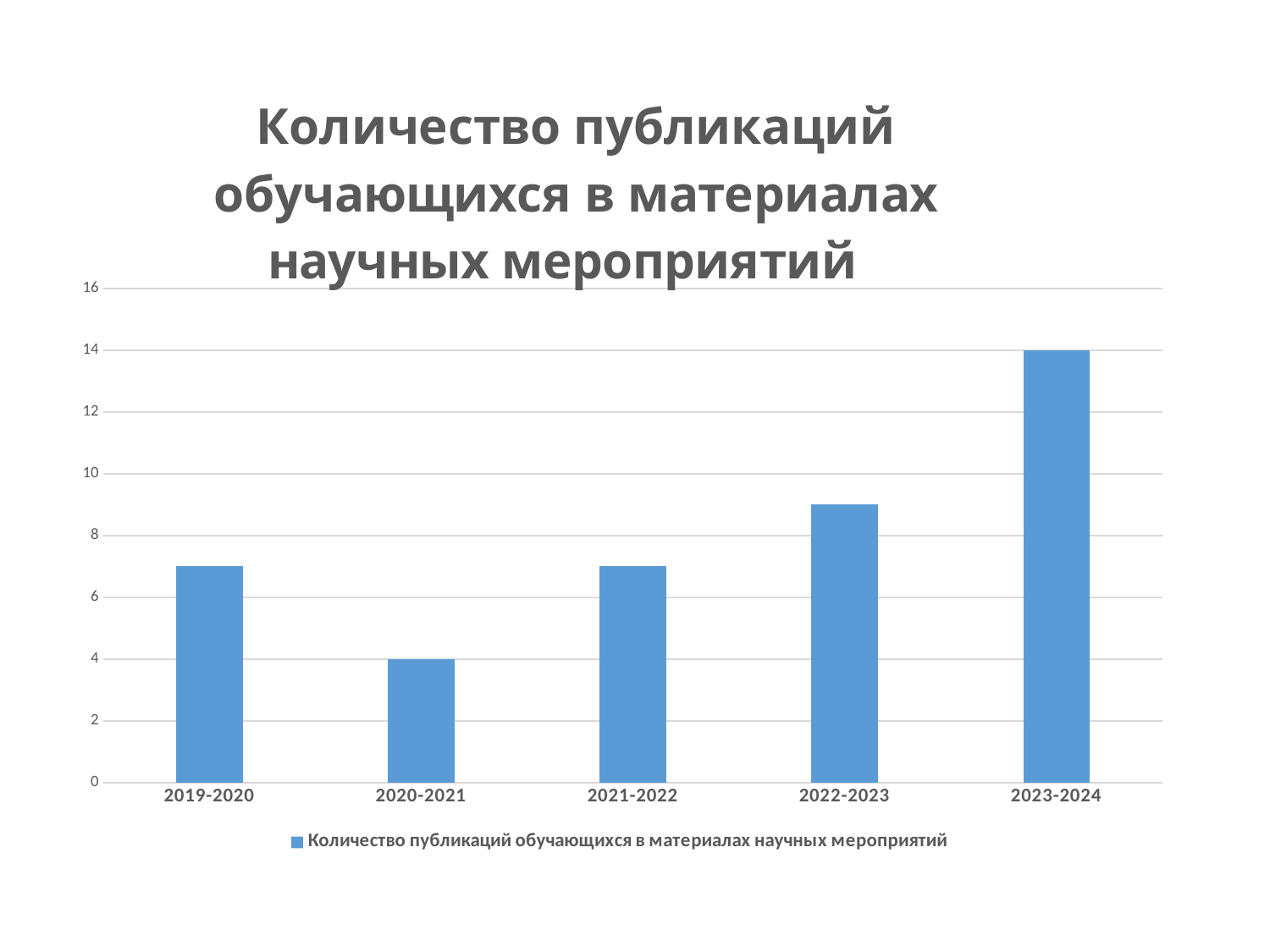
Is the value for 2022-2023 greater or less than 10? less Which academic year has the highest number of publications? 2023-2024 What is the value for 2023-2024? 14 Which is larger, the value for 2022-2023 or the value for 2021-2022? 2022-2023 What is the value for 2020-2021? 4 Is the value for 2019-2020 greater or less than 6? greater How many series does the legend list? 1 Which academic year has the lowest number of publications? 2020-2021 How many academic years are shown on the x axis? 5 Do the values rise or fall from 2020-2021 to 2023-2024? rise What is the difference between the values for 2023-2024 and 2020-2021? 10 What kind of chart is shown on the slide? bar chart